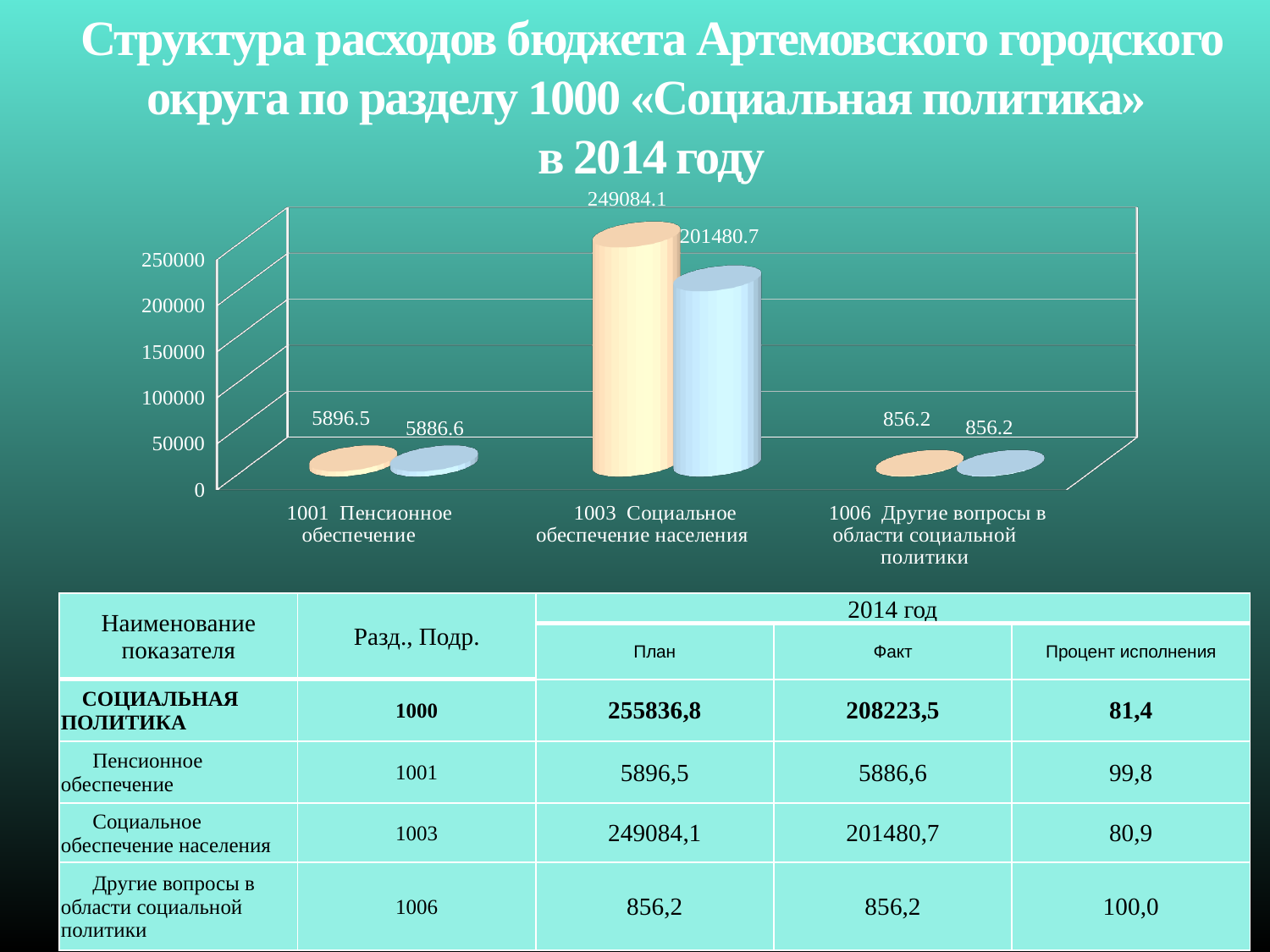
What value is labelled on the second (blue) bar for category 1003 Социальное обеспечение населения? 201480.7 Is the value of the blue bar for category 1003 Социальное обеспечение населения greater or less than 150000? greater Which is larger for category 1003: the peach bar value or the blue bar value? the peach bar value (249084.1) What type of chart is shown on the slide? bar chart What is the difference between the two labelled values for category 1001 Пенсионное обеспечение (5896.5 and 5886.6)? 9.9 What is the difference between the two labelled values for category 1003 Социальное обеспечение населения (249084.1 and 201480.7)? 47603.4 What value is labelled on the first (peach) bar for category 1003 Социальное обеспечение населения? 249084.1 How many categories are shown on the x axis of the chart? 3 What value is labelled on the first (peach) bar for category 1001 Пенсионное обеспечение? 5896.5 Which category has the lowest bars in the chart? 1006 Другие вопросы в области социальной политики Which category has the highest bars in the chart? 1003 Социальное обеспечение населения What value is labelled on the blue bar for category 1006 Другие вопросы в области социальной политики? 856.2